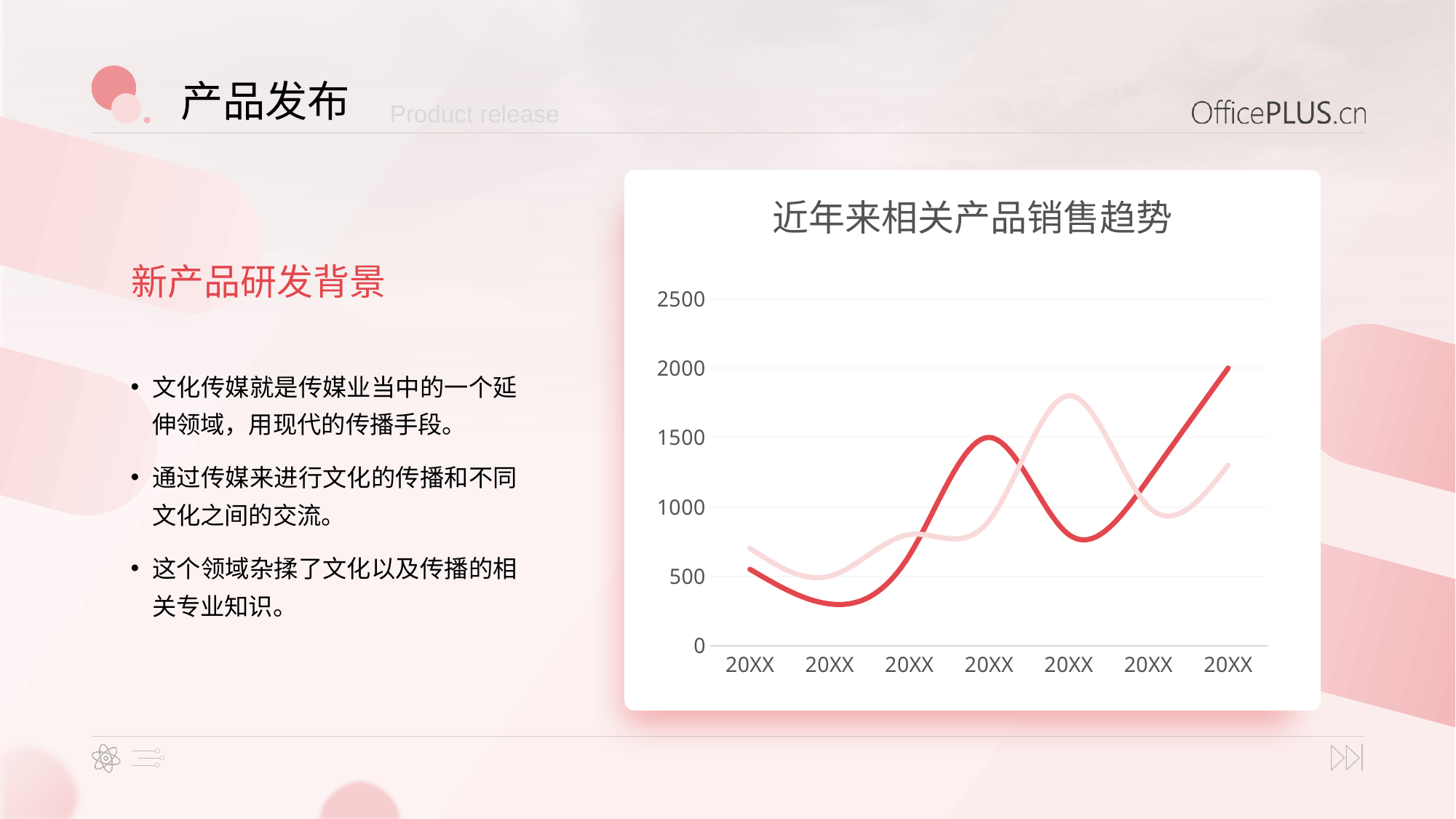
How many points are plotted along the x axis of the chart? 7 What is the title of the chart? 近年来相关产品销售趋势 Is the highest value reached by the light pink line greater or less than 1500? greater Is the value of the dark red line at the last (rightmost) point greater or less than 1500? greater Comparing the first and last points, does the dark red line rise or fall overall across the x axis? rise At the last (rightmost) point, which line is higher, the dark red line or the light pink line? the dark red line Which line reaches the highest value anywhere in the chart, the dark red line or the light pink line? the dark red line Is the lowest value reached by the dark red line greater or less than 500? less How many lines are plotted in the chart? 2 What kind of chart is shown on the slide? line chart